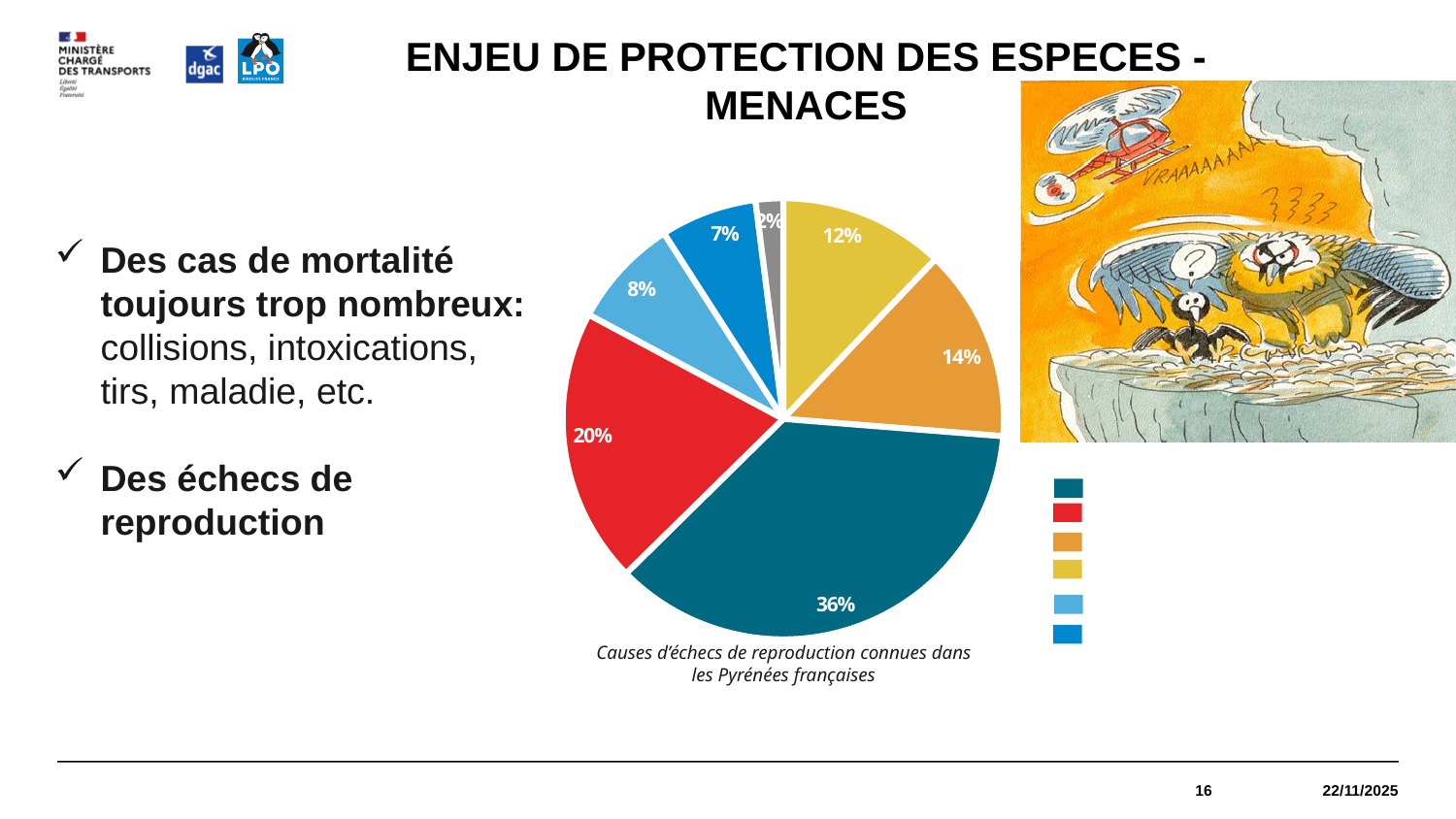
What kind of chart is shown on the slide? pie chart How many slices does the pie chart have? 7 What is the caption written below the pie chart? Causes d'échecs de reproduction connues dans les Pyrénées françaises What percentage is shown on the light blue slice of the pie chart? 8% What percentage is shown on the yellow slice of the pie chart? 12% What is the value of the smallest slice in the pie chart? 2% What colour is the largest slice of the pie chart? dark teal What percentage is shown on the red slice of the pie chart? 20% What is the difference between the largest slice (36%) and the red slice (20%)? 16 percentage points What percentage is shown on the orange slice of the pie chart? 14% What is the value of the largest slice in the pie chart? 36% Which slice is larger, the red slice or the orange slice? the red slice (20%)